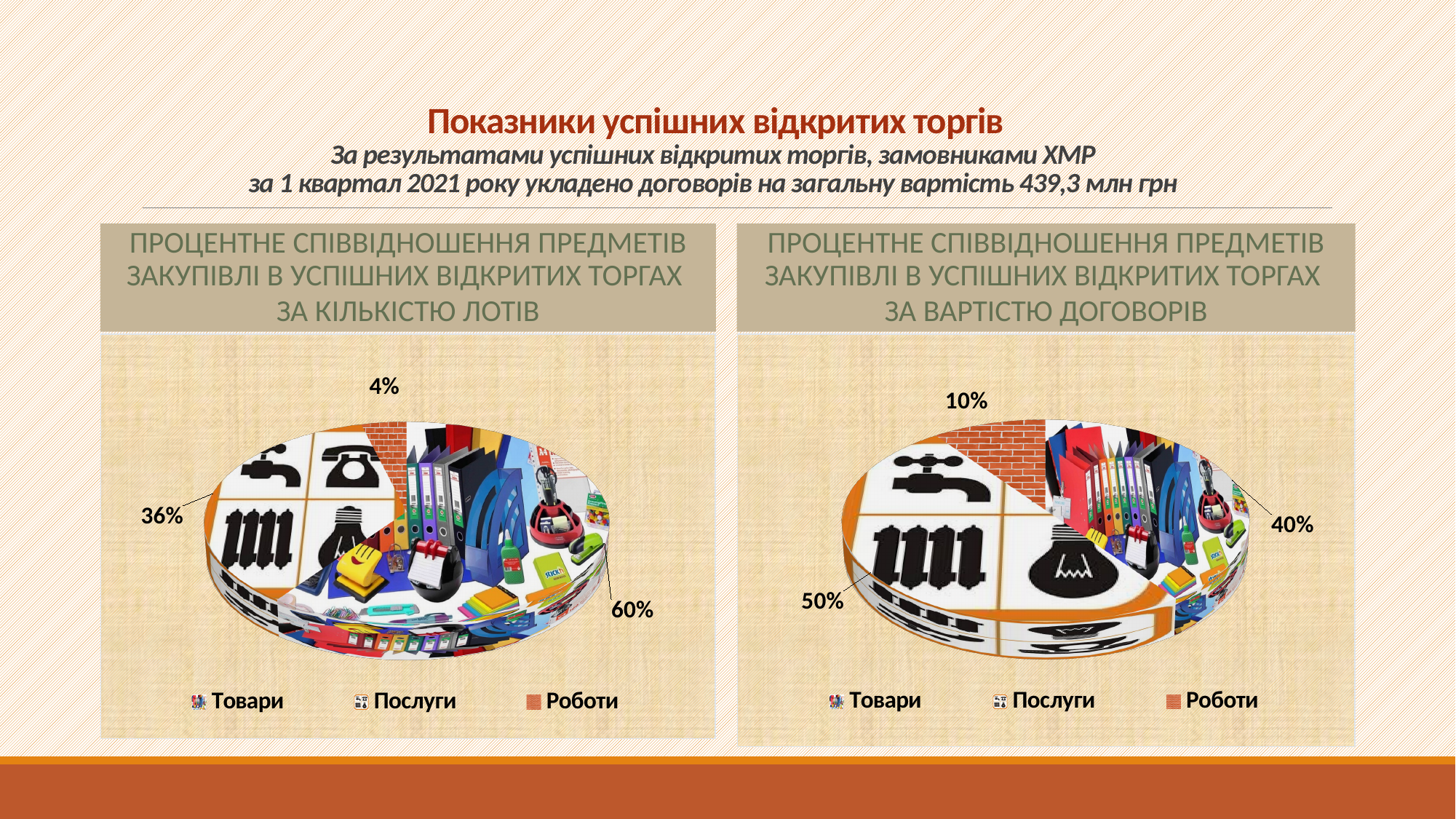
In the right pie chart (за вартістю договорів), what share is labelled for Товари? 40% In the right pie chart (за вартістю договорів), which category has the smallest share? Роботи In the left pie chart (за кількістю лотів), what share is labelled for Роботи? 4% In the left pie chart (за кількістю лотів), what share is labelled for Послуги? 36% In the right pie chart (за вартістю договорів), what share is labelled for Послуги? 50% How many categories does the legend of the right pie chart list? 3 What type of chart is used on the left side of the slide? Pie chart In the right pie chart (за вартістю договорів), what share is labelled for Роботи? 10% In the left pie chart (за кількістю лотів), what is the difference between the shares of Товари and Послуги? 24% In the left pie chart (за кількістю лотів), which category has the largest share? Товари In the right pie chart (за вартістю договорів), which is larger: the share of Послуги or the share of Товари? Послуги In the left pie chart (за кількістю лотів), what share is labelled for Товари? 60%